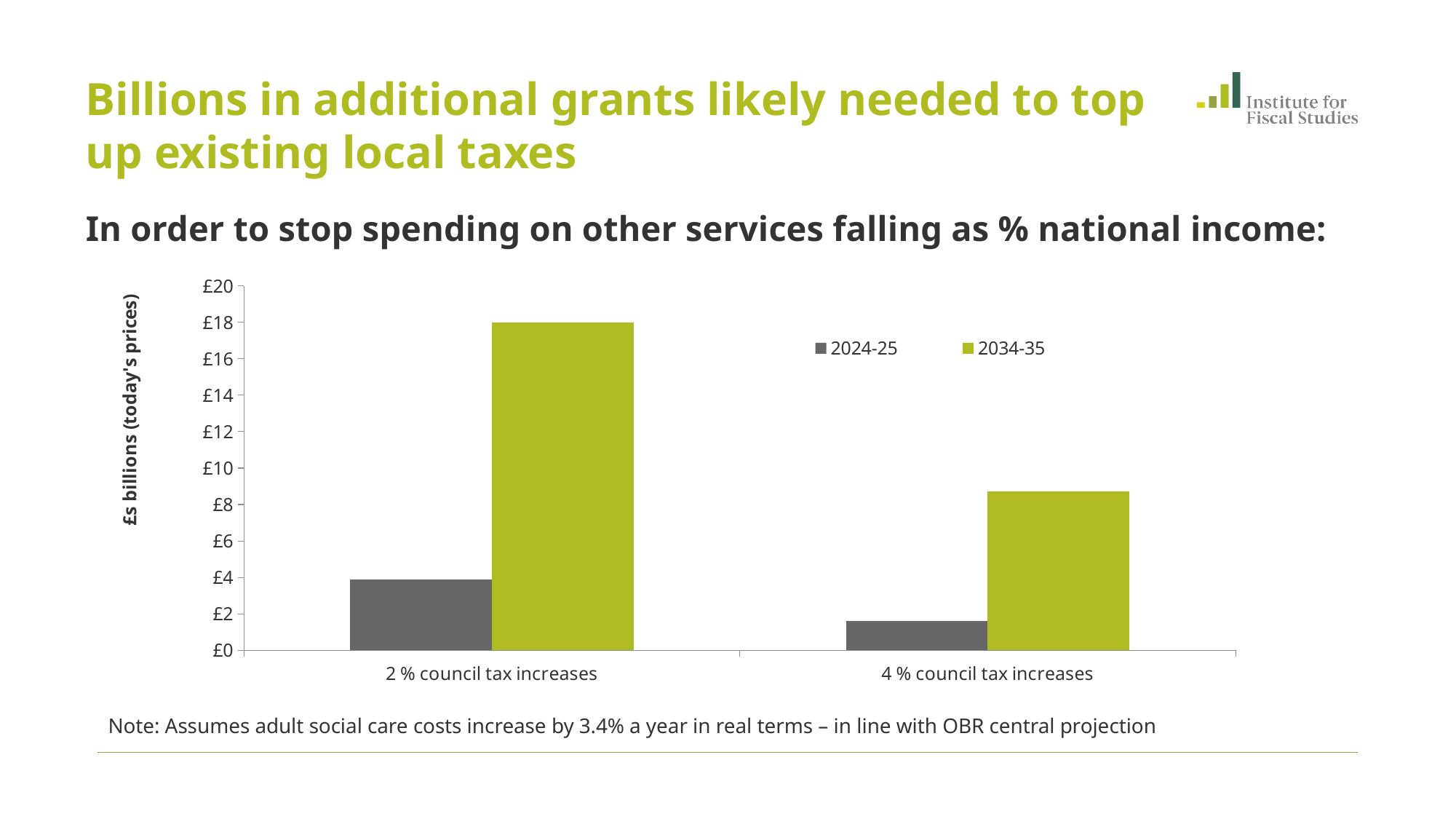
Do the 2034-35 values rise or fall from 2 % council tax increases to 4 % council tax increases? fall How many series does the legend list? 2 Which series and category has the lowest bar? 2024-25, 4 % council tax increases Is the 2034-35 value for 2 % council tax increases greater or less than £16? greater What kind of chart is shown on the slide? bar chart Is the 2024-25 value for 4 % council tax increases greater or less than £2? less For 4 % council tax increases, which series has the larger value, 2024-25 or 2034-35? 2034-35 Is the 2034-35 value for 4 % council tax increases greater or less than £10? less Which series and category has the highest bar? 2034-35, 2 % council tax increases How many categories are shown on the x axis? 2 What is the label on the vertical axis? £s billions (today's prices)